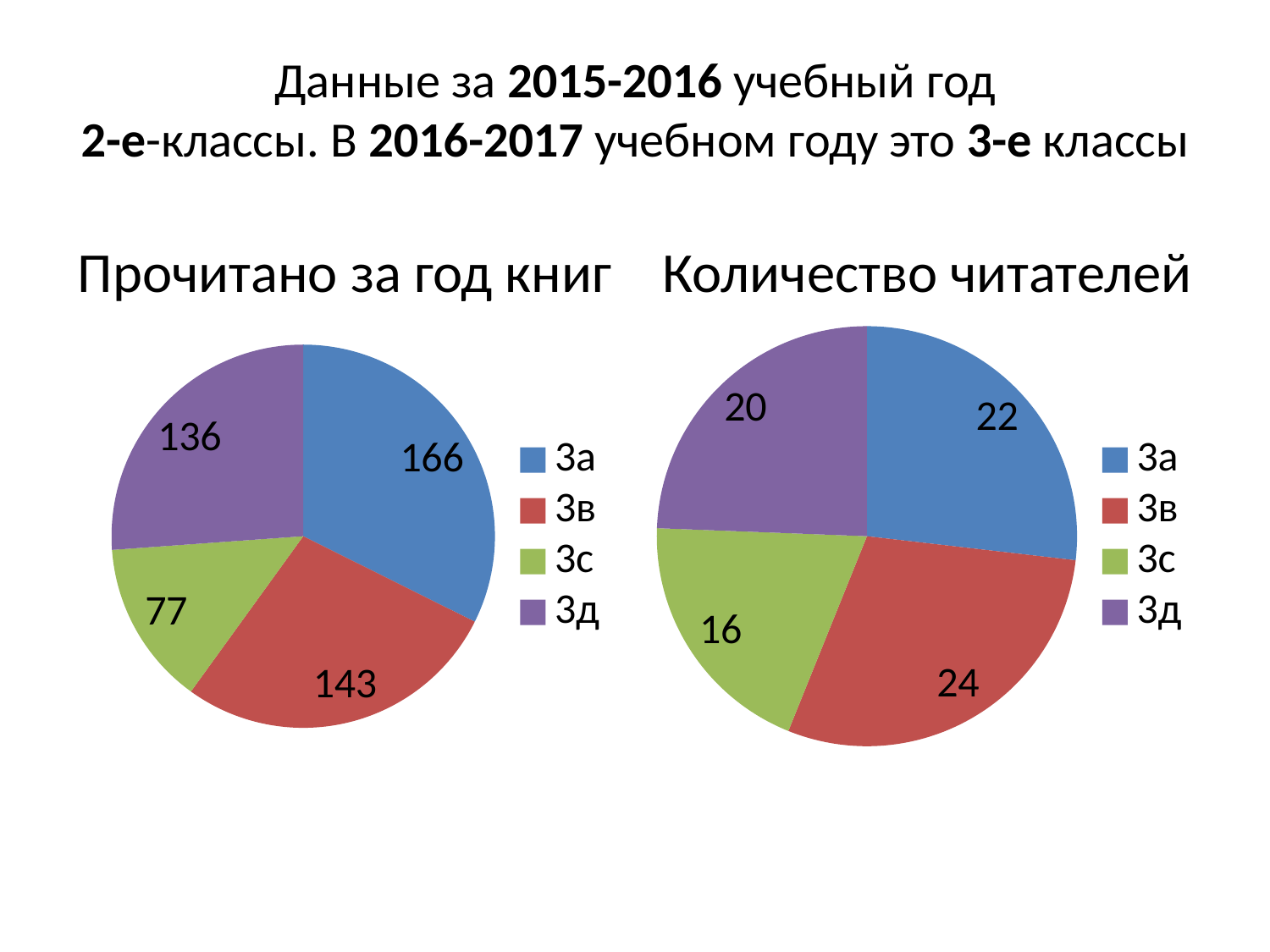
In the chart titled "Количество читателей", which class has the lowest value? 3с In the chart titled "Прочитано за год книг", what is the value for 3а? 166 In the chart titled "Количество читателей", what is the value for 3д? 20 What type of chart is the chart titled "Прочитано за год книг"? pie chart In the chart titled "Прочитано за год книг", which is larger, the value for 3в or the value for 3д? 3в In the chart titled "Прочитано за год книг", what is the difference between the values for 3а and 3в? 23 In the chart titled "Количество читателей", what is the difference between the values for 3в and 3с? 8 In the chart titled "Прочитано за год книг", what is the value for 3с? 77 In the chart titled "Количество читателей", what colour is the slice for 3с? green In the chart titled "Количество читателей", what is the value for 3в? 24 How many slices does the chart titled "Количество читателей" have? 4 In the chart titled "Прочитано за год книг", which class has the highest value? 3а